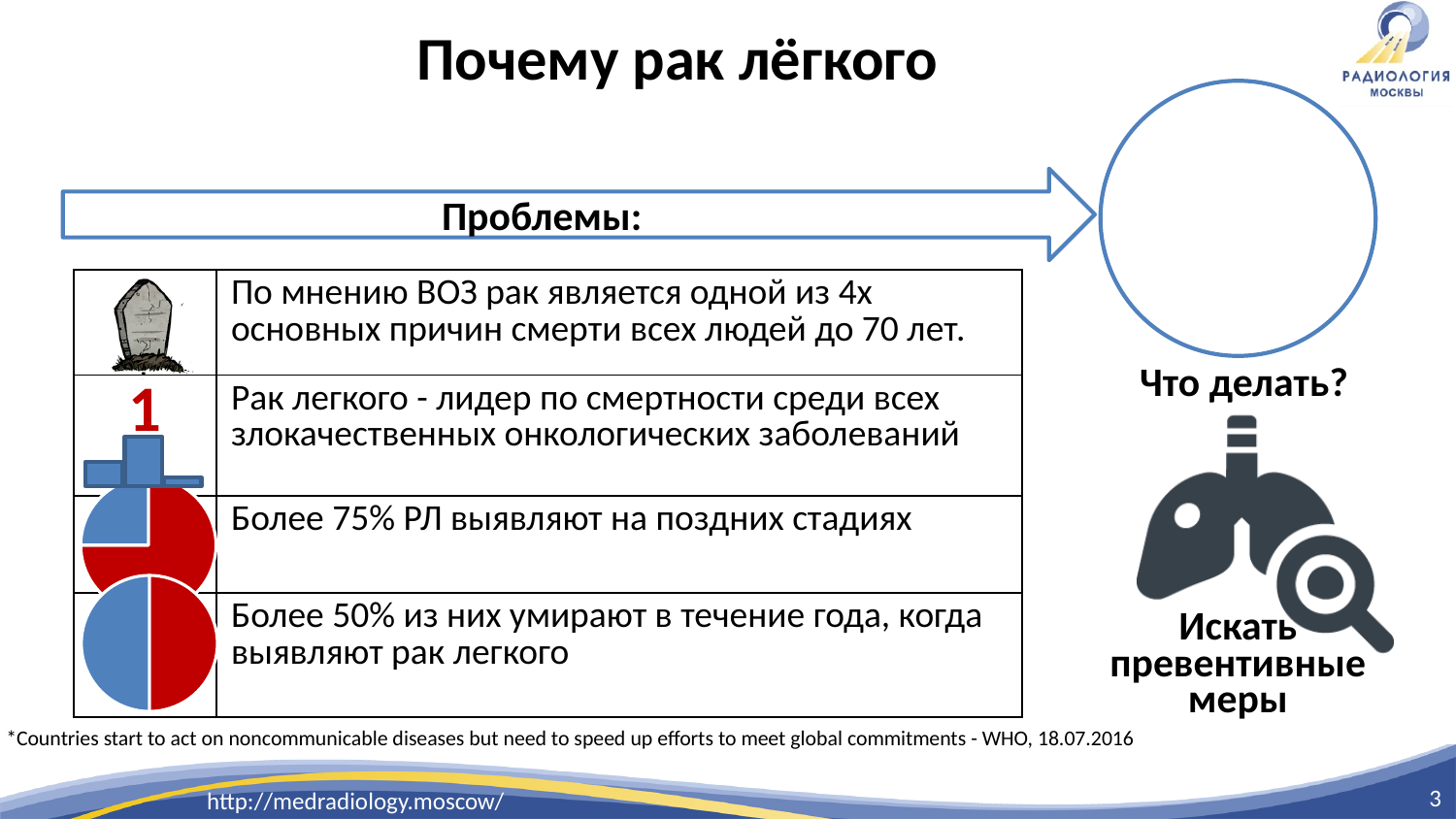
How many pie charts are shown on the slide? 2 In the upper pie chart (next to the 'Более 75%' row), which slice is larger, the red one or the blue one? red How many slices does the lower pie chart (next to the 'Более 50%' row) have? 2 What kind of chart is the small graphic next to the row 'Более 75% РЛ выявляют на поздних стадиях'? pie chart What kind of chart is the small graphic next to the row 'Более 50% из них умирают в течение года, когда выявляют рак легкого'? pie chart How many slices does the upper pie chart (next to the 'Более 75%' row) have? 2 What two colours are used for the slices in the pie charts on the slide? red and blue